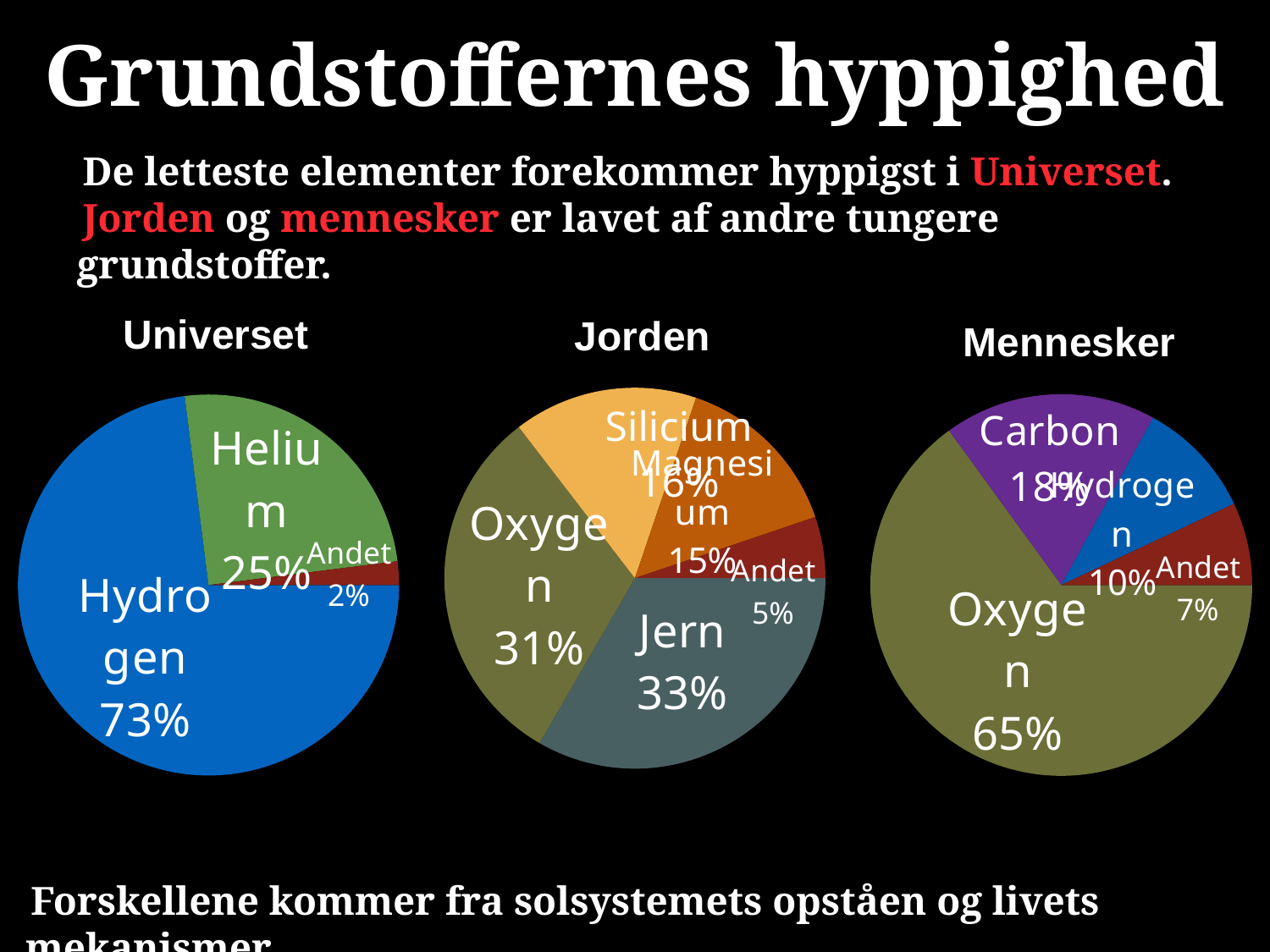
In the Mennesker pie chart, which is larger, Carbon or Hydrogen? Carbon In the Jorden pie chart, how many slices are there? 5 In the Universet pie chart, what percentage is Hydrogen? 73% In the Universet pie chart, which slice is the smallest? Andet What kind of charts are shown on the slide? Pie charts In the Mennesker pie chart, what percentage is Oxygen? 65% In the Universet pie chart, how many slices are there? 3 In the Jorden pie chart, what percentage is Jern? 33% In the Universet pie chart, what percentage is Helium? 25% In the Jorden pie chart, what is the difference between Oxygen and Andet? 26% In the Jorden pie chart, which slice is the largest? Jern In the Mennesker pie chart, what percentage is Andet? 7%